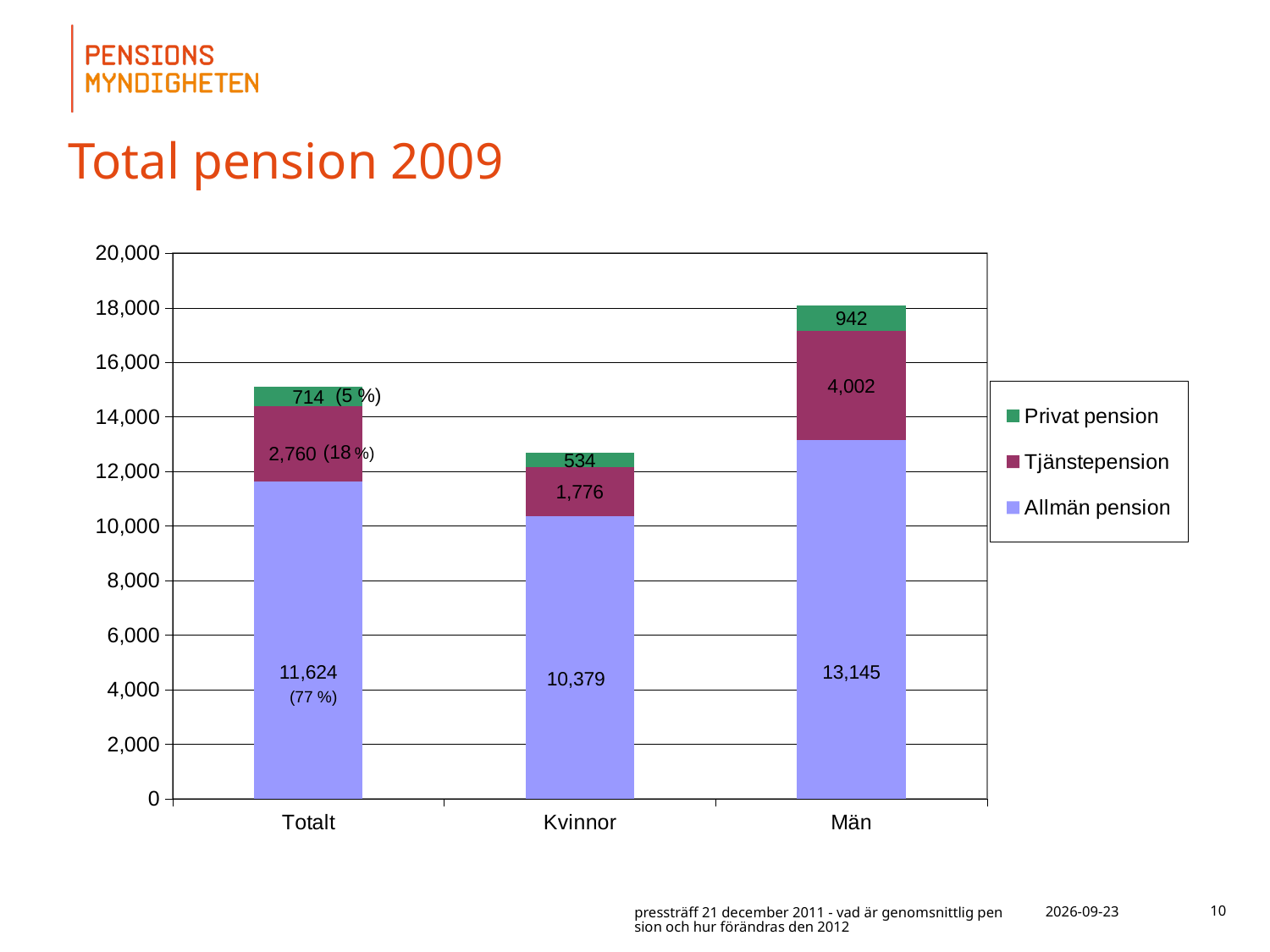
Is the Privat pension value larger for Män or for Kvinnor? Män What is the total of the stacked bar for Män? 18,089 What is the total of the stacked bar for Kvinnor? 12,689 Which category has the lowest Allmän pension value? Kvinnor What kind of chart is shown on the slide? Stacked bar chart What is the Allmän pension value for Män? 13,145 What is the Privat pension value for Totalt? 714 What is the Tjänstepension value for Kvinnor? 1,776 What is the difference between the Tjänstepension values for Män and Kvinnor? 2,226 Which category has the highest Tjänstepension value? Män How many categories are shown on the x axis? 3 How many series does the legend list? 3